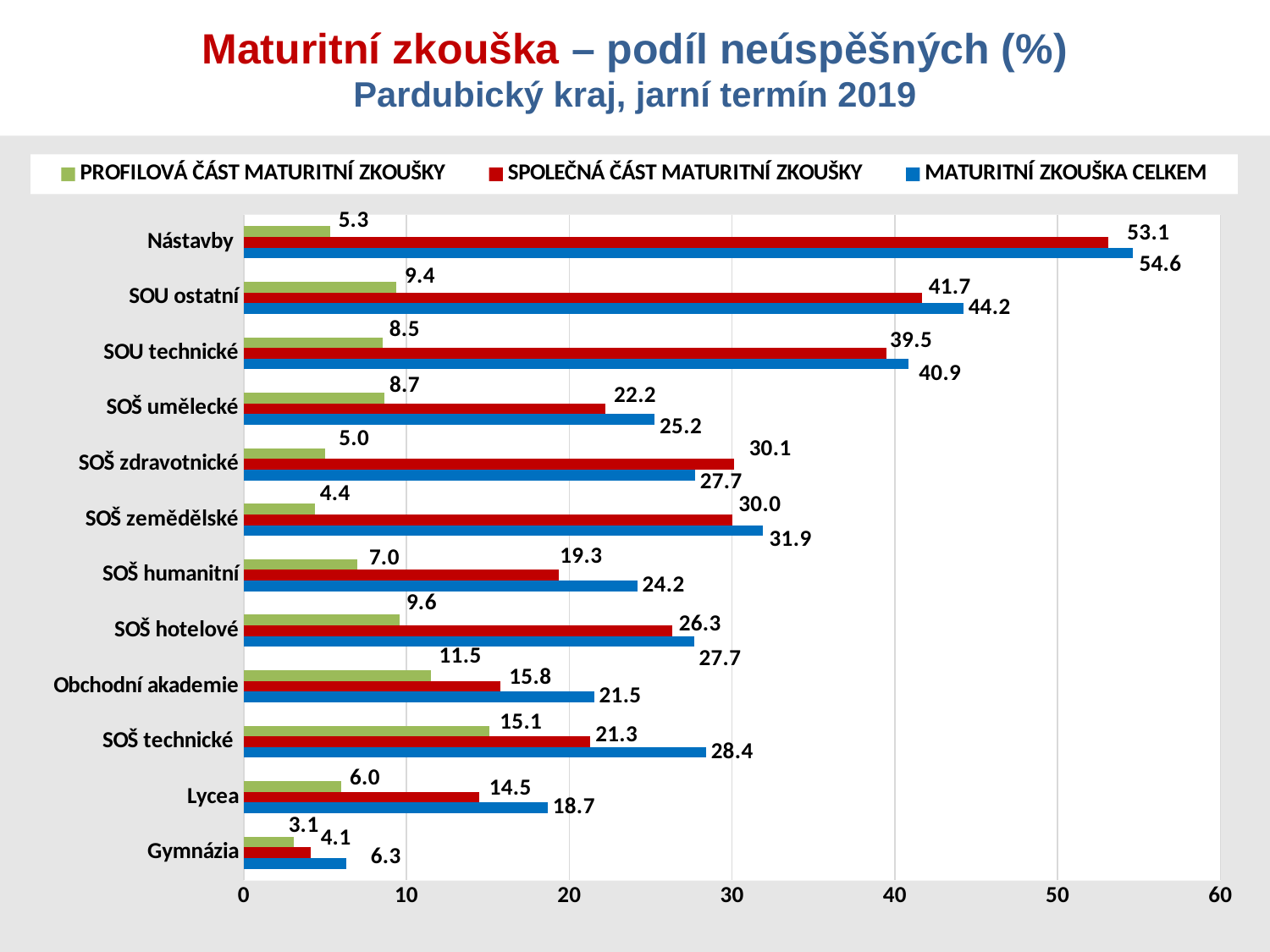
How many categories are shown on the chart? 12 Is the MATURITNÍ ZKOUŠKA CELKEM value for SOU technické greater or less than 40? greater What is the value of SPOLEČNÁ ČÁST MATURITNÍ ZKOUŠKY for SOŠ hotelové? 26.3 Which is larger for SOŠ zdravotnické: SPOLEČNÁ ČÁST MATURITNÍ ZKOUŠKY or MATURITNÍ ZKOUŠKA CELKEM? SPOLEČNÁ ČÁST MATURITNÍ ZKOUŠKY What kind of chart is shown on the slide? Bar chart Which category has the highest value for PROFILOVÁ ČÁST MATURITNÍ ZKOUŠKY? SOŠ technické Which category has the highest value for MATURITNÍ ZKOUŠKA CELKEM? Nástavby What is the value of PROFILOVÁ ČÁST MATURITNÍ ZKOUŠKY for Obchodní akademie? 11.5 How many series does the legend list? 3 What is the value of MATURITNÍ ZKOUŠKA CELKEM for Nástavby? 54.6 Which category has the lowest value for MATURITNÍ ZKOUŠKA CELKEM? Gymnázia What is the difference between the SPOLEČNÁ ČÁST and PROFILOVÁ ČÁST values for Nástavby? 47.8